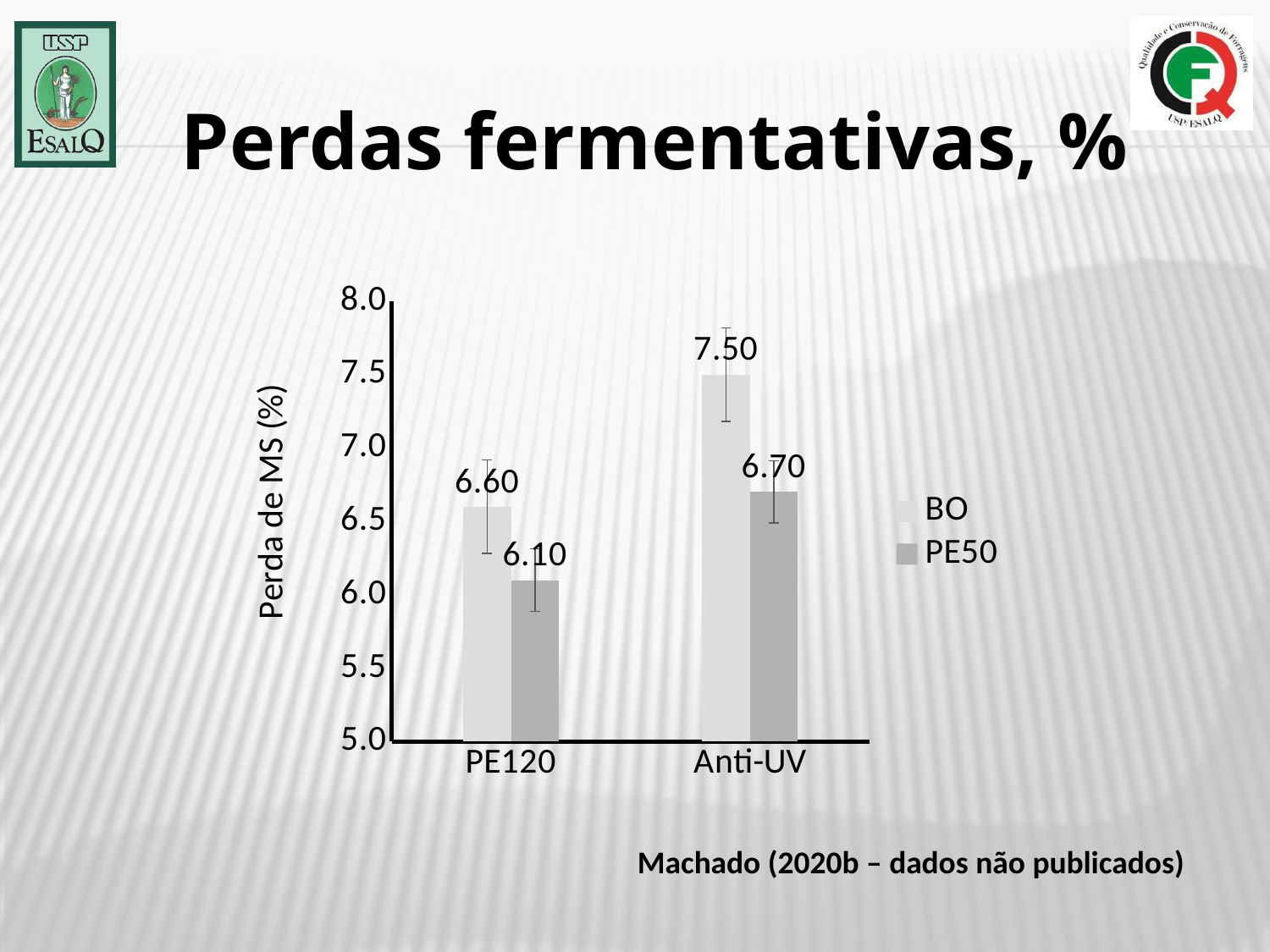
What is the value for PE50 in the PE120 category? 6.10 Which bar has the lowest value on the chart? PE50 in PE120 Which bar has the highest value on the chart? BO in Anti-UV How many series does the legend list? 2 How many categories are shown on the x axis? 2 What is the difference between the BO values for Anti-UV and PE120? 0.90 What is the value for BO in the Anti-UV category? 7.50 What is the difference between the BO and PE50 values in the Anti-UV category? 0.80 What is the value for BO in the PE120 category? 6.60 What kind of chart is shown on the slide? Bar chart What is the value for PE50 in the Anti-UV category? 6.70 Which is larger, the PE50 value for PE120 or the PE50 value for Anti-UV? PE50 for Anti-UV